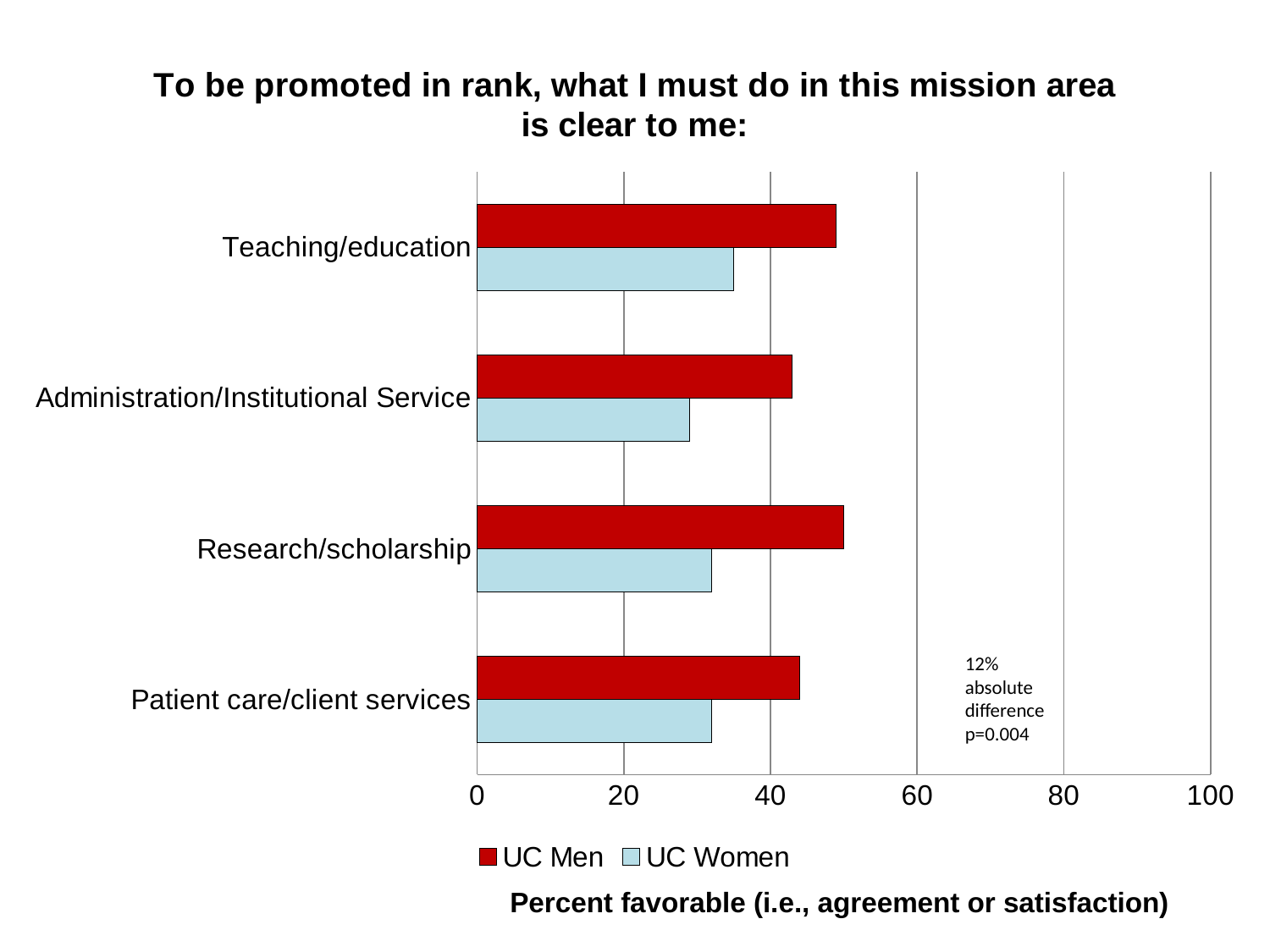
Is the value for UC Women in Patient care/client services greater or less than 40? less What is the label of the horizontal axis? Percent favorable (i.e., agreement or satisfaction) Is the value for UC Women in Teaching/education greater or less than 40? less For Administration/Institutional Service, which series has the larger value, UC Men or UC Women? UC Men Is the value for UC Men in Teaching/education greater or less than 40? greater What colour are the UC Men bars? red How many series does the legend list? 2 For Research/scholarship, which series has the larger value, UC Men or UC Women? UC Men How many mission-area categories are plotted on the chart? 4 What kind of chart is shown on the slide? bar chart